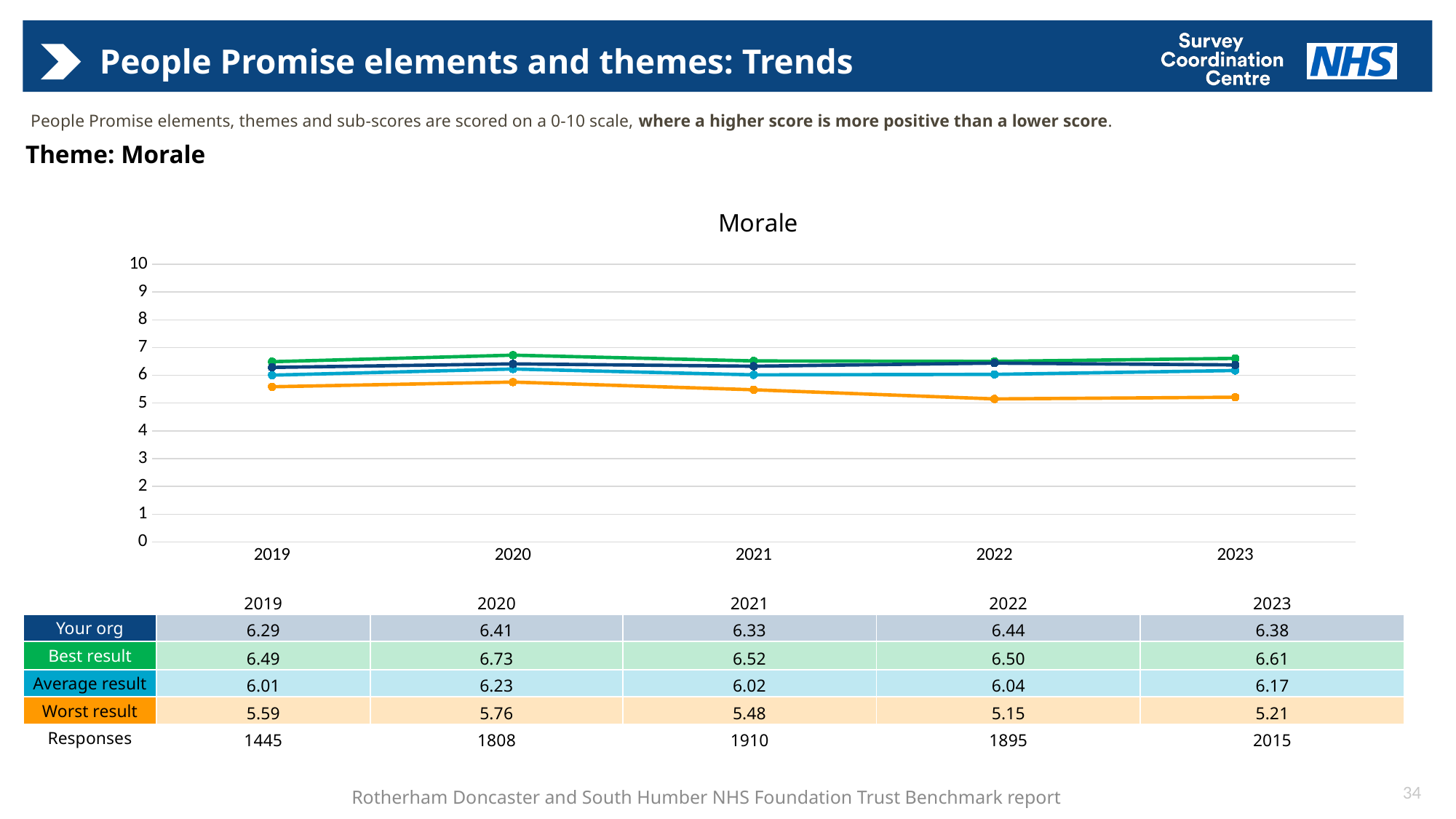
In which year was the Worst result Morale score lowest? 2022 What is the Best result Morale score in 2020? 6.73 What type of chart is shown on the slide? line chart In which year was the Best result Morale score highest? 2020 What is the difference between the Best result and Your org Morale scores in 2023? 0.23 What is the Average result Morale score in 2021? 6.02 What is the Morale score for Your org in 2022? 6.44 How many series are plotted in the Morale chart? 4 What is the Worst result Morale score in 2023? 5.21 Which is higher in 2019: Your org or Average result? Your org Did the Worst result Morale score rise or fall from 2020 to 2022? fall How many years are plotted on the x axis of the Morale chart? 5